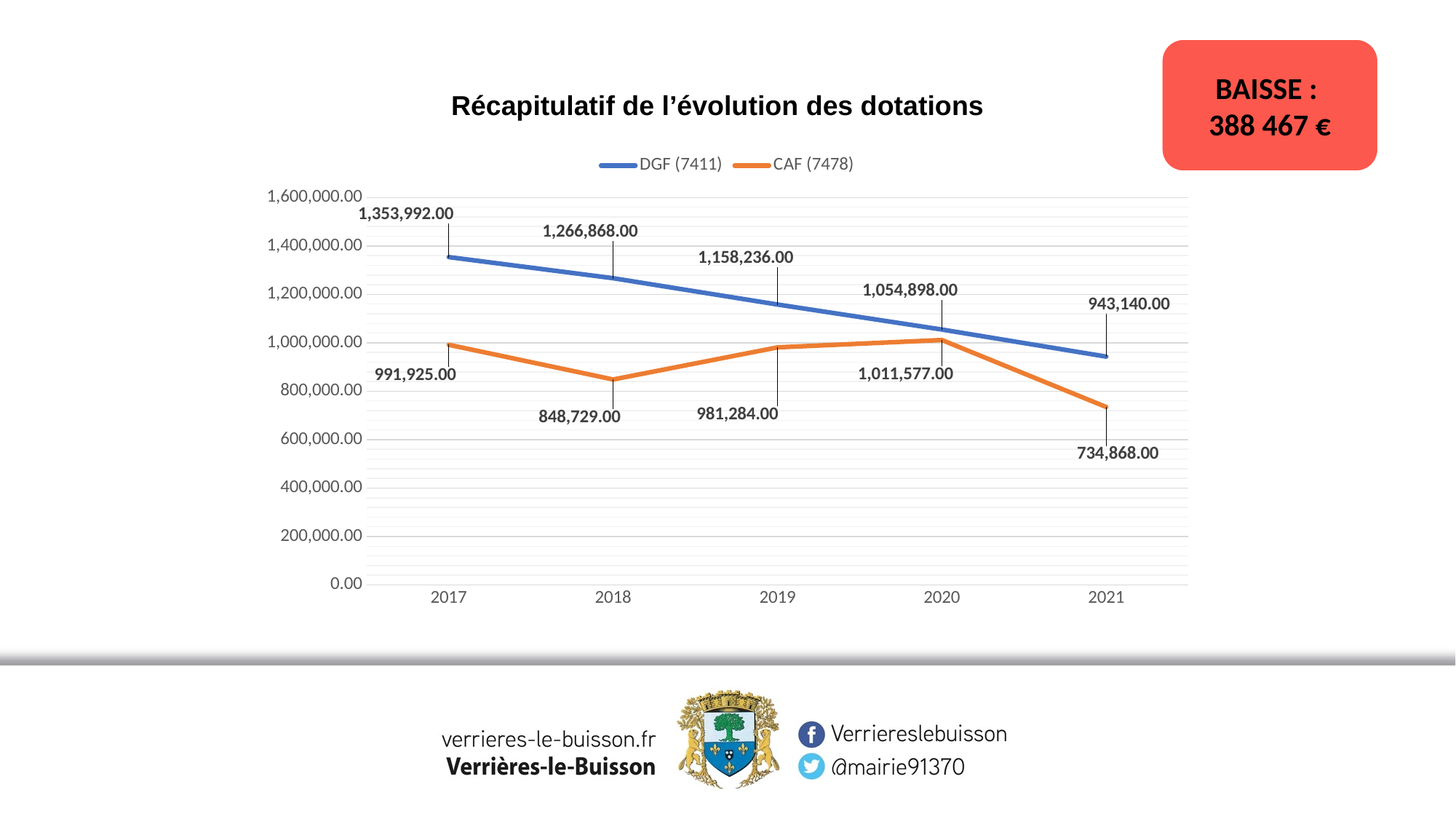
What is the value of CAF (7478) in 2021? 734,868.00 By how much did DGF (7411) decrease between 2017 and 2021? 410,852.00 Is the value for CAF (7478) in 2021 greater or less than 800,000.00? less How many years are shown on the x axis? 5 What is the value of CAF (7478) in 2019? 981,284.00 What is the difference between CAF (7478) in 2020 and in 2021? 276,709.00 Which series has the larger value in 2021, DGF (7411) or CAF (7478)? DGF (7411) In which year is CAF (7478) at its highest? 2020 In which year is DGF (7411) at its lowest? 2021 How many series does the legend list? 2 What is the value of DGF (7411) in 2017? 1,353,992.00 What kind of chart is shown on the slide? line chart